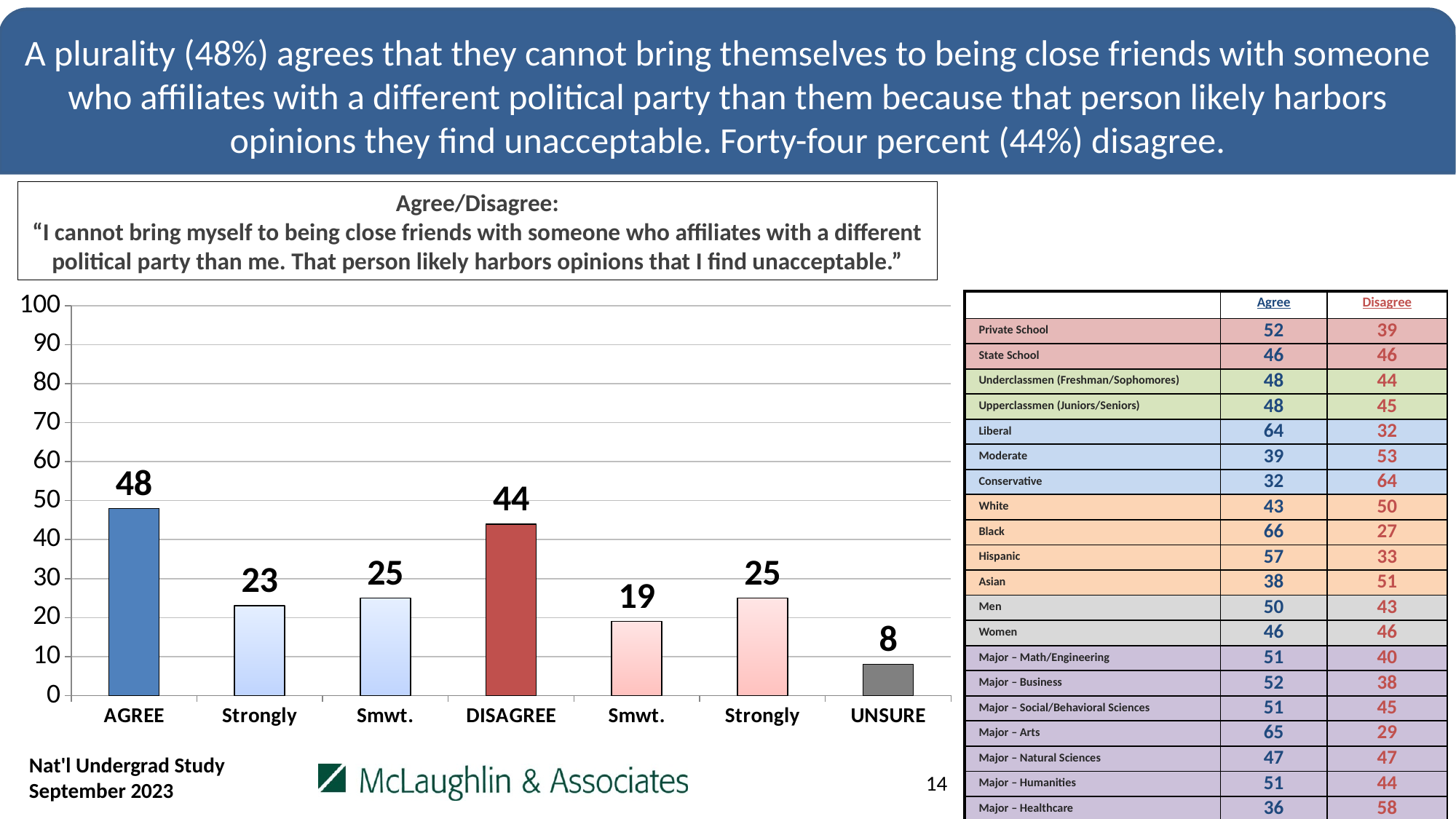
What colour is the DISAGREE bar? Red Which is larger, the AGREE bar or the DISAGREE bar? AGREE What is the value of the DISAGREE bar? 44 How many bars are plotted in the chart? 7 Which category has the highest bar? AGREE What is the difference between the AGREE bar and the DISAGREE bar? 4 What is the value of the Smwt. bar immediately to the right of DISAGREE? 19 What kind of chart is shown on the slide? Bar chart Which category has the lowest bar? UNSURE What is the value of the AGREE bar? 48 What is the value of the UNSURE bar? 8 What is the value of the second bar from the left, labelled Strongly (under AGREE)? 23